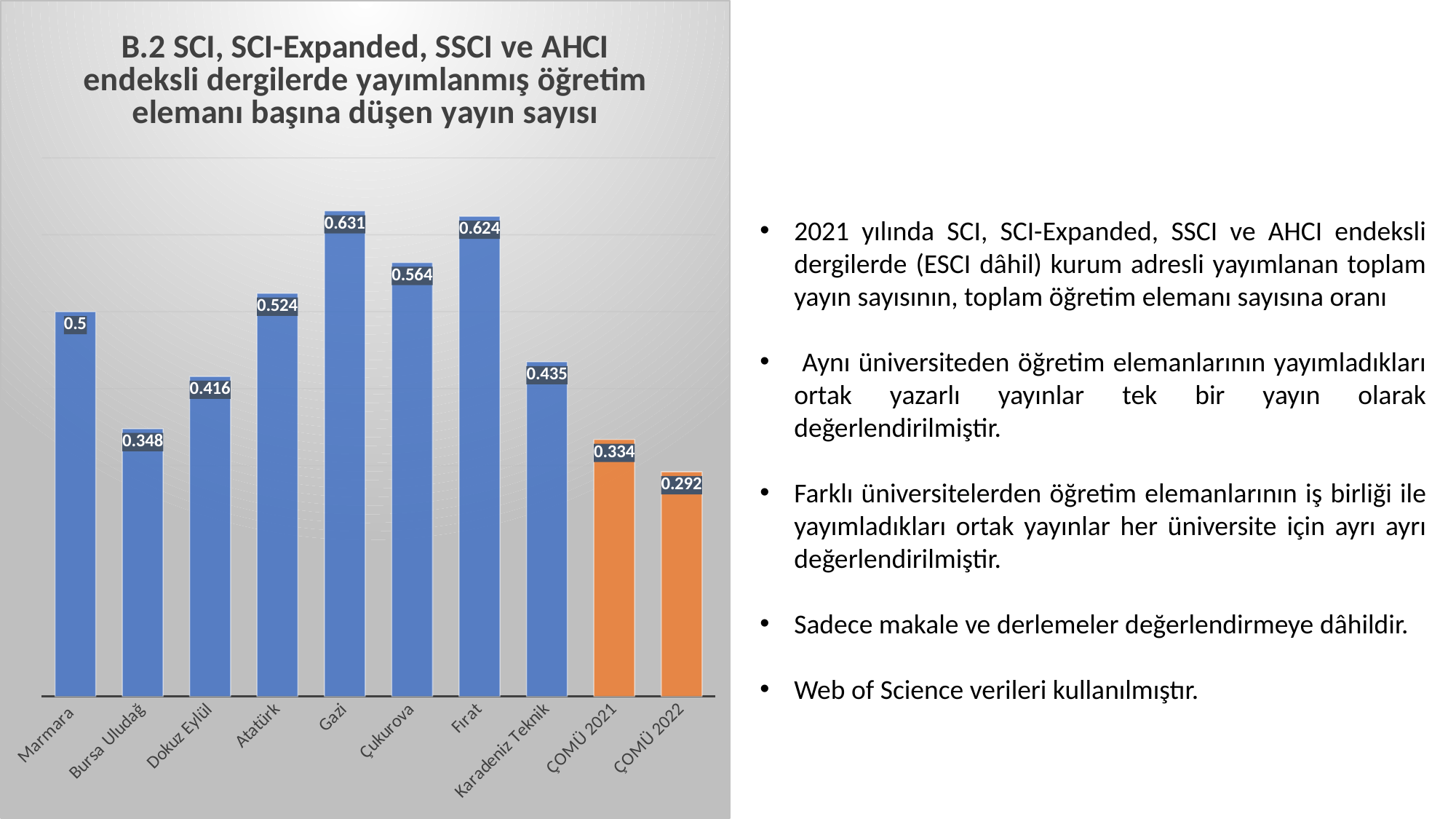
How many categories are shown on the x axis? 10 Which is larger, the value for Marmara or the value for Atatürk? Atatürk What is the value for Karadeniz Teknik? 0.435 What is the value for Gazi? 0.631 What kind of chart is shown on the slide? Bar chart What is the value for ÇOMÜ 2022? 0.292 What is the difference between the values for ÇOMÜ 2021 and ÇOMÜ 2022? 0.042 Which two categories are shown with orange bars instead of blue? ÇOMÜ 2021 and ÇOMÜ 2022 Which category has the highest value? Gazi What is the difference between the values for Gazi and Fırat? 0.007 Which category has the lowest value? ÇOMÜ 2022 Which is larger, the value for Bursa Uludağ or the value for Dokuz Eylül? Dokuz Eylül